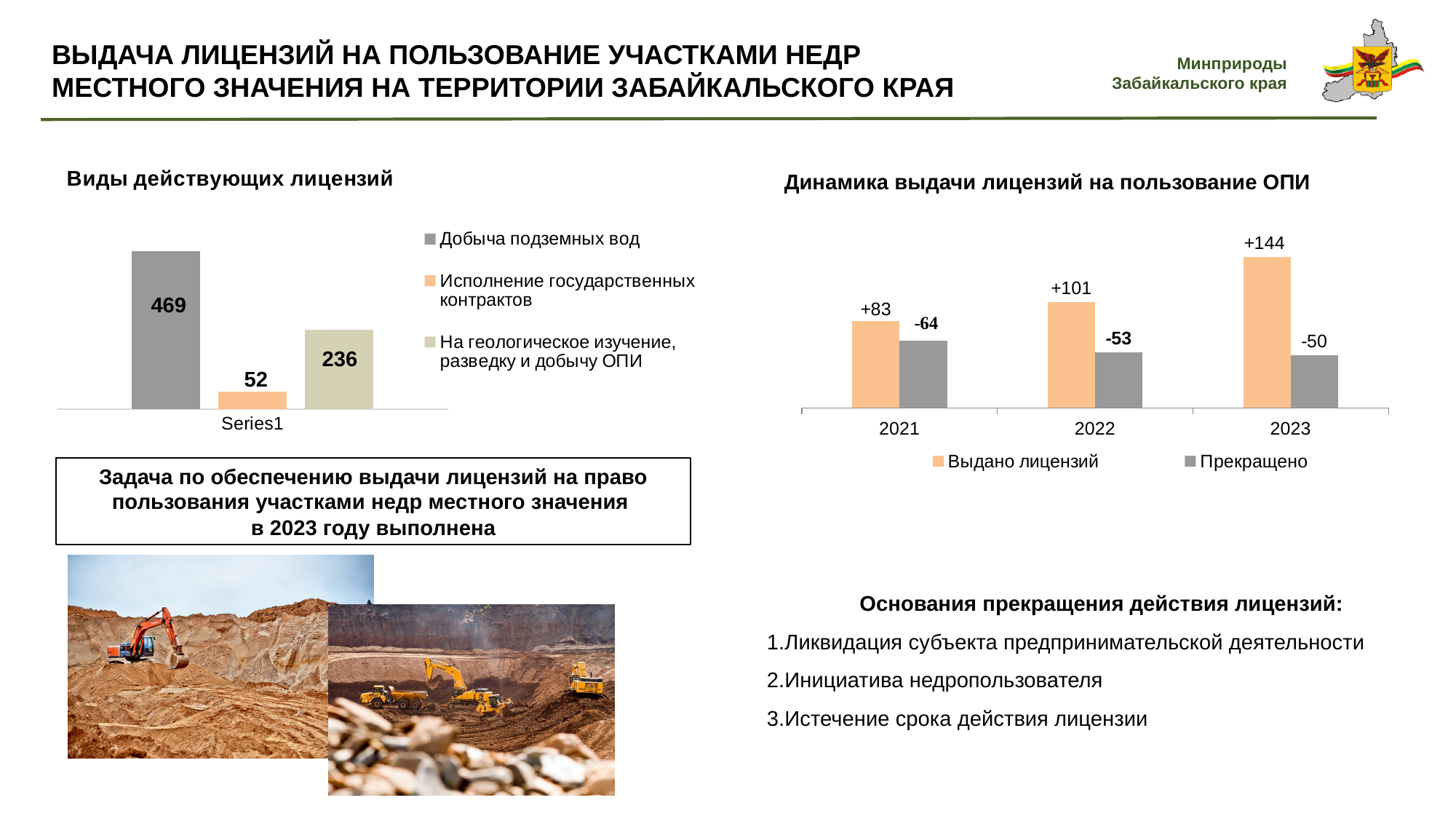
In the chart 'Динамика выдачи лицензий на пользование ОПИ', what is the value for 'Выдано лицензий' in 2022? +101 In the chart 'Динамика выдачи лицензий на пользование ОПИ', which is larger: 'Выдано лицензий' in 2021 or 'Выдано лицензий' in 2023? 2023 In the chart 'Динамика выдачи лицензий на пользование ОПИ', does the value for 'Выдано лицензий' rise or fall from 2021 to 2023? rise In the chart 'Динамика выдачи лицензий на пользование ОПИ', what is the value for 'Прекращено' in 2021? -64 In the chart 'Динамика выдачи лицензий на пользование ОПИ', how many years are shown on the x axis? 3 In the chart 'Виды действующих лицензий', what is the value for 'Добыча подземных вод'? 469 In the chart 'Динамика выдачи лицензий на пользование ОПИ', in which year is the value for 'Выдано лицензий' highest? 2023 In the chart 'Виды действующих лицензий', how many series does the legend list? 3 In the chart 'Виды действующих лицензий', what is the difference between 'Добыча подземных вод' and 'На геологическое изучение, разведку и добычу ОПИ'? 233 In the chart 'Виды действующих лицензий', which series has the lowest value? Исполнение государственных контрактов In the chart 'Виды действующих лицензий', what is the value for 'Исполнение государственных контрактов'? 52 What kind of chart is 'Динамика выдачи лицензий на пользование ОПИ'? bar chart